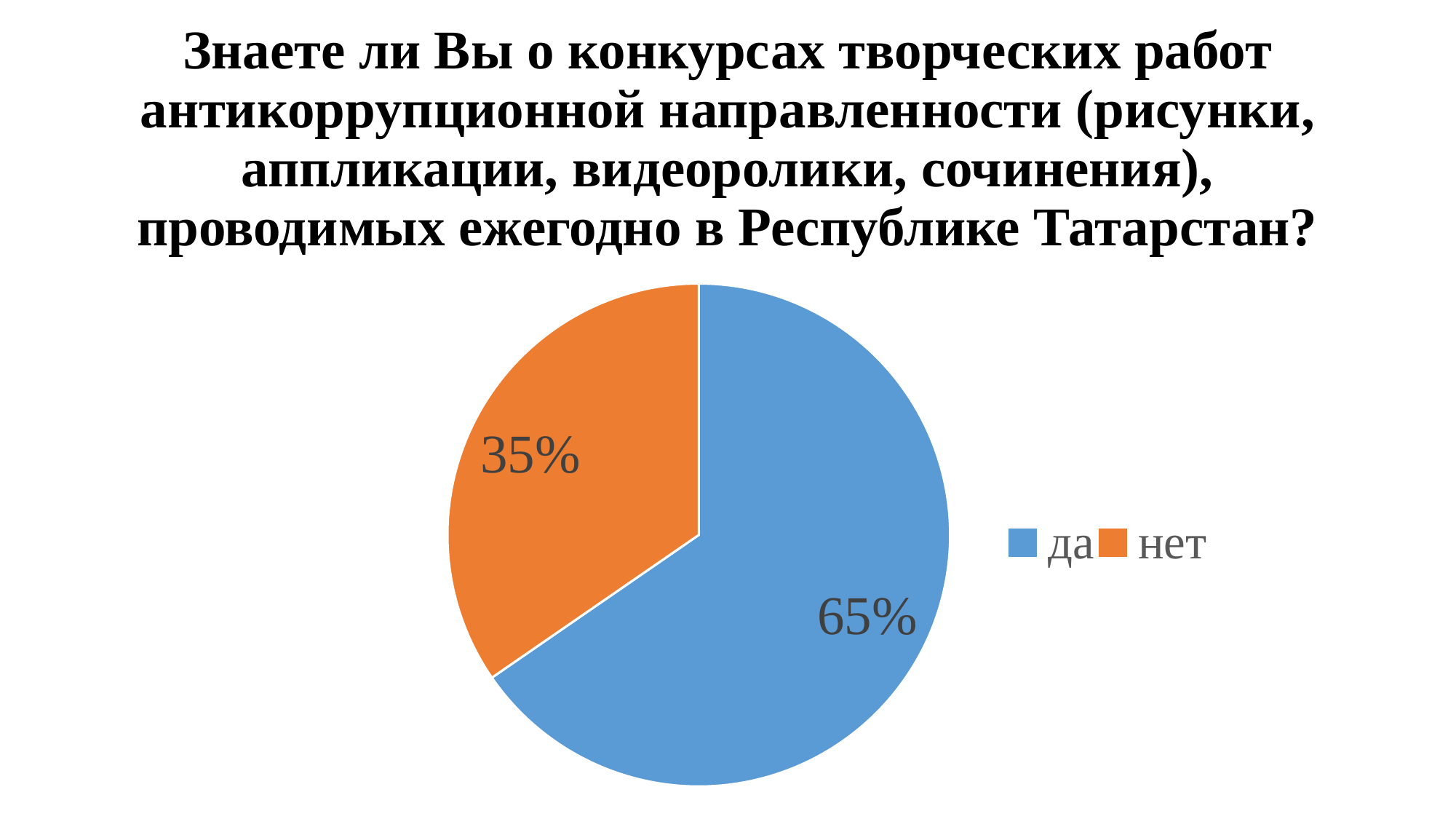
Which slice is larger, "да" or "нет"? да What is the difference in percentage points between the "да" and "нет" slices? 30 Which answer has the largest share of the pie? да Which answer has the smallest share of the pie? нет What colour is the "да" slice? blue What kind of chart is shown on the slide? pie chart What percentage of respondents answered "да"? 65% What colour is the "нет" slice? orange What percentage of respondents answered "нет"? 35% What share of the pie does the "нет" slice represent? 35% How many entries does the legend list? 2 How many slices does the pie chart have? 2